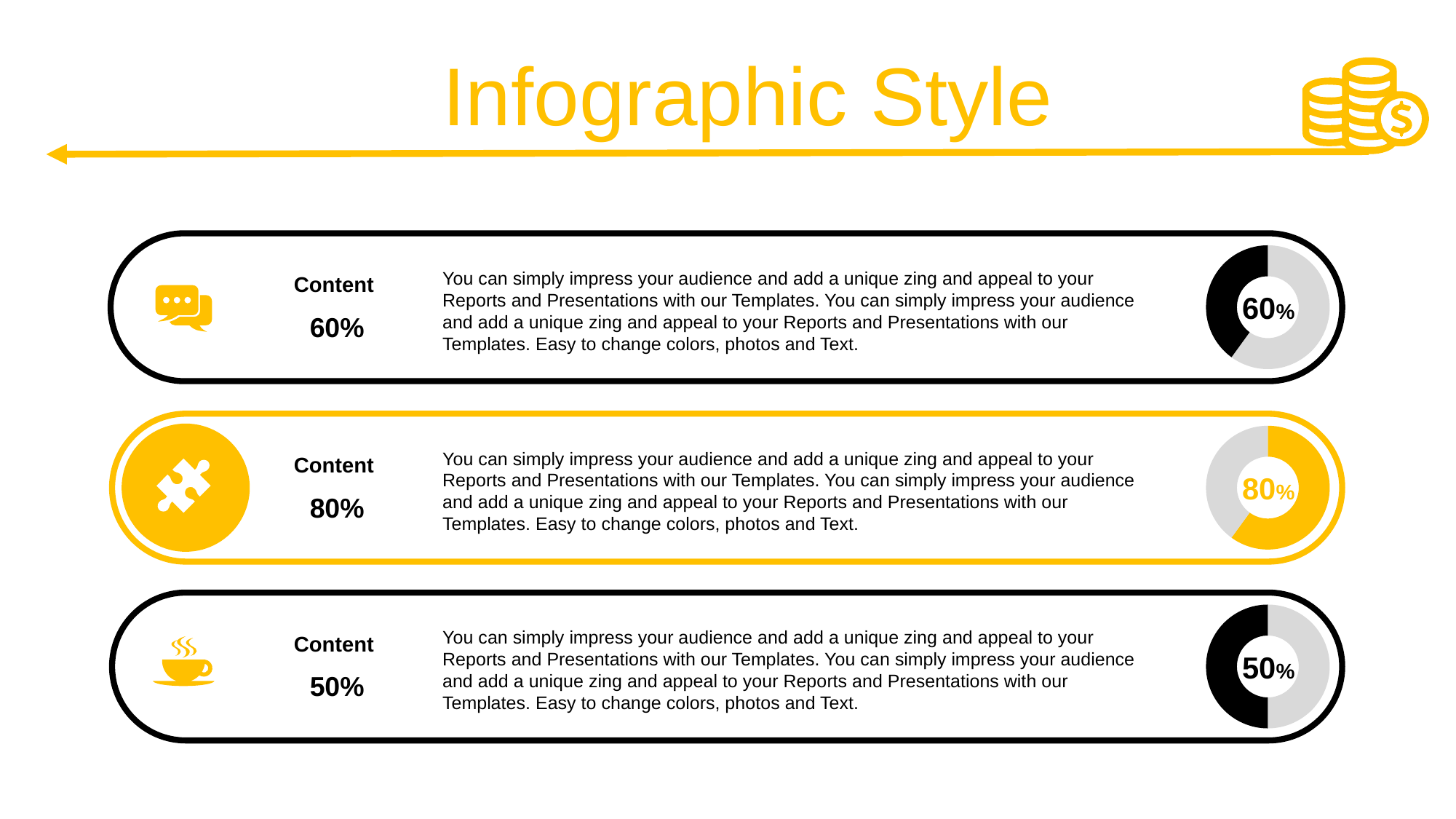
What value is shown in the centre of the bottom donut chart? 50% Which of the three donut charts shows the lowest percentage? The bottom one (50%) What is the difference between the percentage in the top donut chart and the percentage in the bottom donut chart? 10% What colour is the filled portion of the middle donut chart? Yellow What value is shown in the centre of the top donut chart? 60% How many donut charts are on the slide? 3 Is the percentage in the top donut chart larger or smaller than the percentage in the bottom donut chart? larger Which of the three donut charts shows the highest percentage? The middle one (80%) What kind of chart is used to show the percentages on the right side of each row? Donut chart What value is shown in the centre of the middle donut chart? 80% What is the difference between the percentage in the middle donut chart and the percentage in the top donut chart? 20% What colour is the filled portion of the top and bottom donut charts? Black